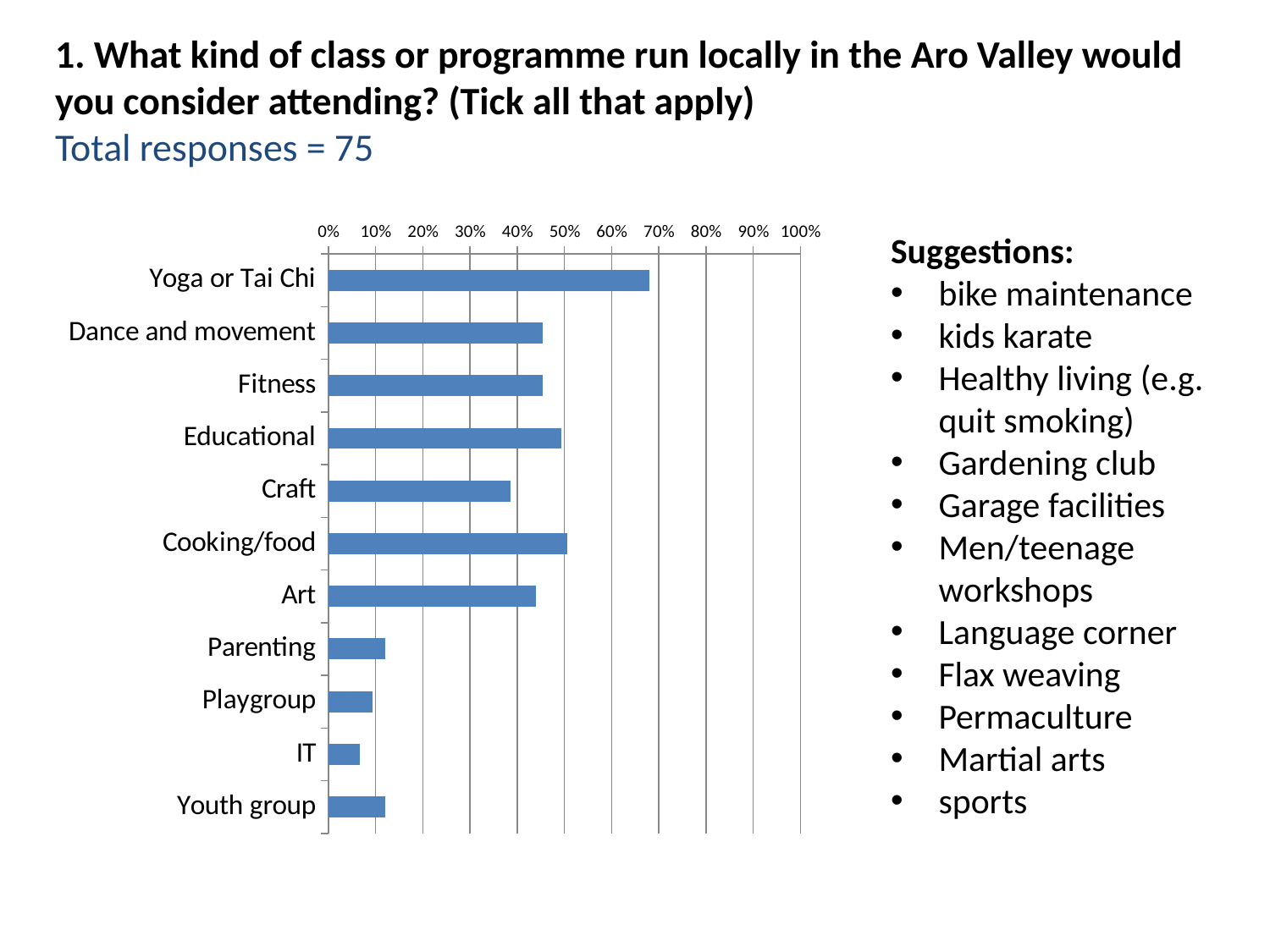
Which is larger, the value for Yoga or Tai Chi or the value for Cooking/food? Yoga or Tai Chi How many categories (class or programme types) are plotted in the chart? 11 Is the value for Art greater or less than 30%? greater Is the value for Yoga or Tai Chi greater or less than 60%? greater Is the value for IT greater or less than 10%? less Which category has the highest value in the chart? Yoga or Tai Chi What is the maximum value shown on the chart's percentage axis? 100% Which is larger, the value for Parenting or the value for Playgroup? Parenting Which is larger, the value for Educational or the value for Craft? Educational What kind of chart is shown on the slide? bar chart